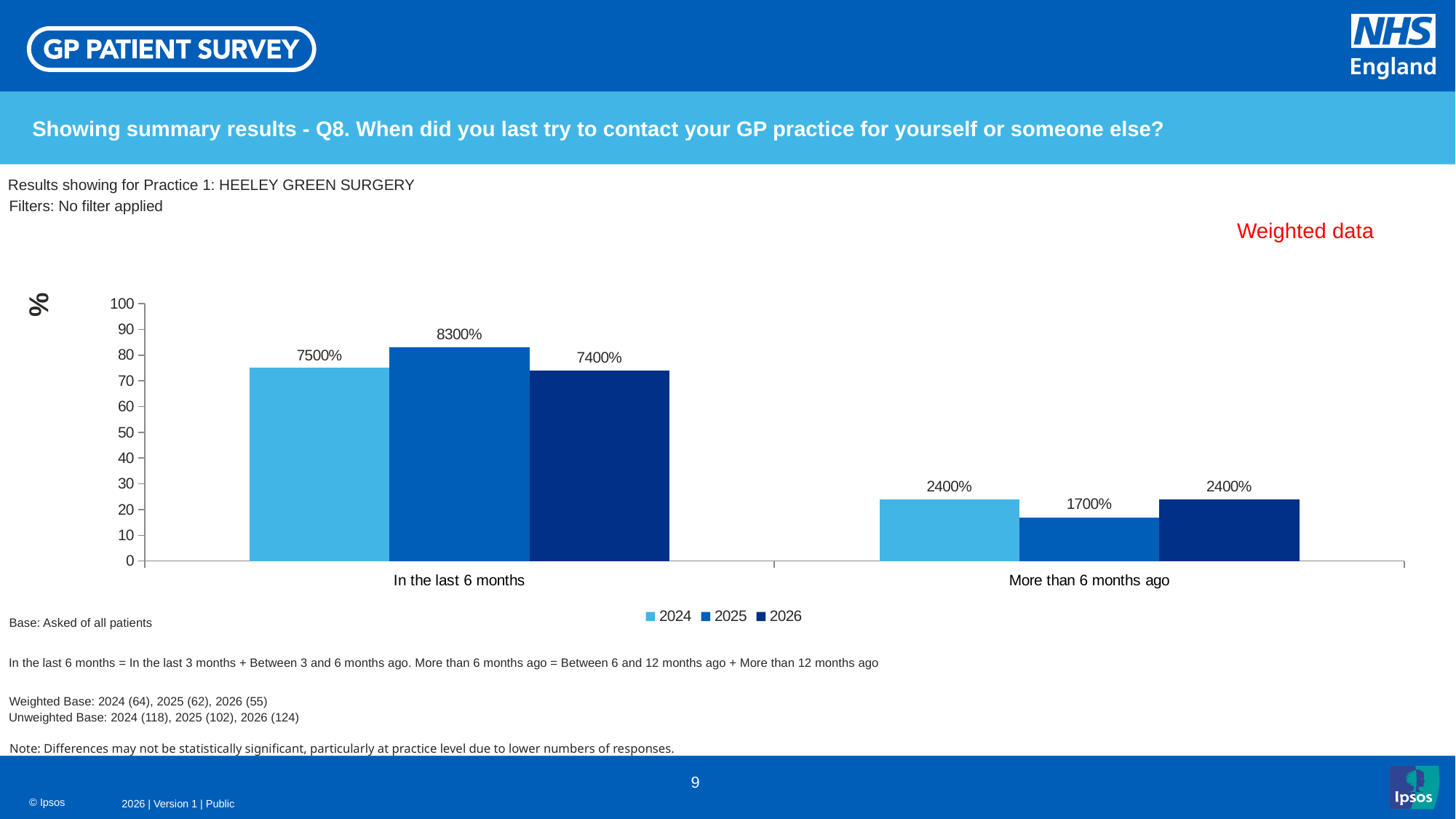
What is the value for 2026 in the 'More than 6 months ago' category? 2400% What is the value for 2025 in the 'More than 6 months ago' category? 1700% What is the value for 2024 in the 'In the last 6 months' category? 7500% What kind of chart is shown on the slide? bar chart Is the 2024 value for 'In the last 6 months' larger or smaller than the 2024 value for 'More than 6 months ago'? larger How many categories are shown on the x axis? 2 Which year has the highest value in the 'In the last 6 months' category? 2025 What is the difference between the 2025 and 2026 values in the 'In the last 6 months' category? 900% What is the value for 2025 in the 'In the last 6 months' category? 8300% Which year has the lowest value in the 'More than 6 months ago' category? 2025 Which practice are the results shown for? HEELEY GREEN SURGERY How many series does the legend list? 3